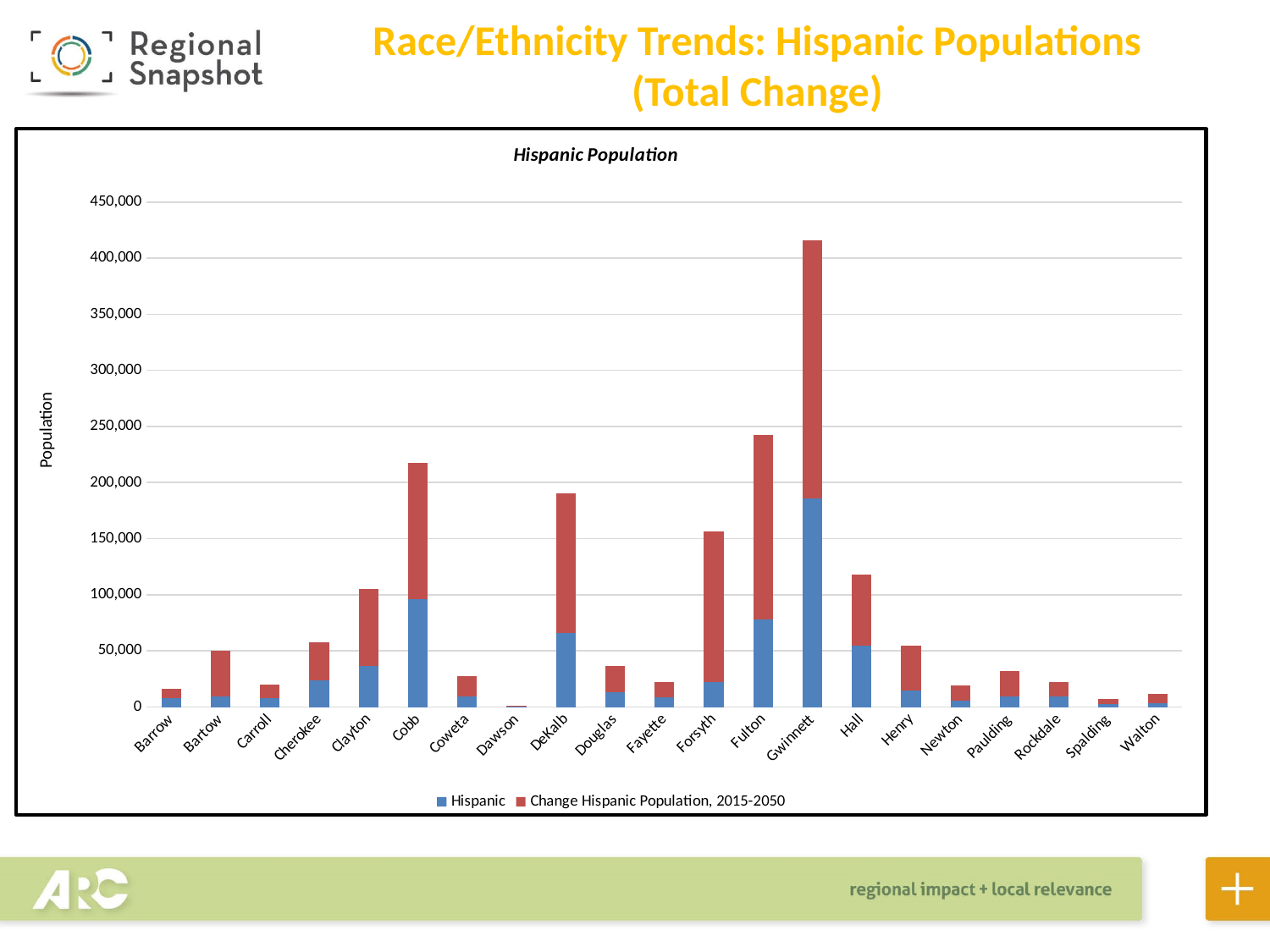
Is the total stacked bar for Gwinnett greater or less than 400,000? greater Which county has the shortest stacked bar in the chart? Dawson Which county has the larger total stacked bar, Fulton or Forsyth? Fulton Which county has the larger total stacked bar, Cobb or DeKalb? Cobb Which county has the tallest stacked bar in the chart? Gwinnett Is the total stacked bar for Fulton greater or less than 250,000? less How many series does the chart's legend list? 2 What kind of chart is shown on the slide? Stacked bar chart What is the title of the chart? Hispanic Population Is the total stacked bar for DeKalb greater or less than 200,000? less How many counties are shown along the x axis of the chart? 21